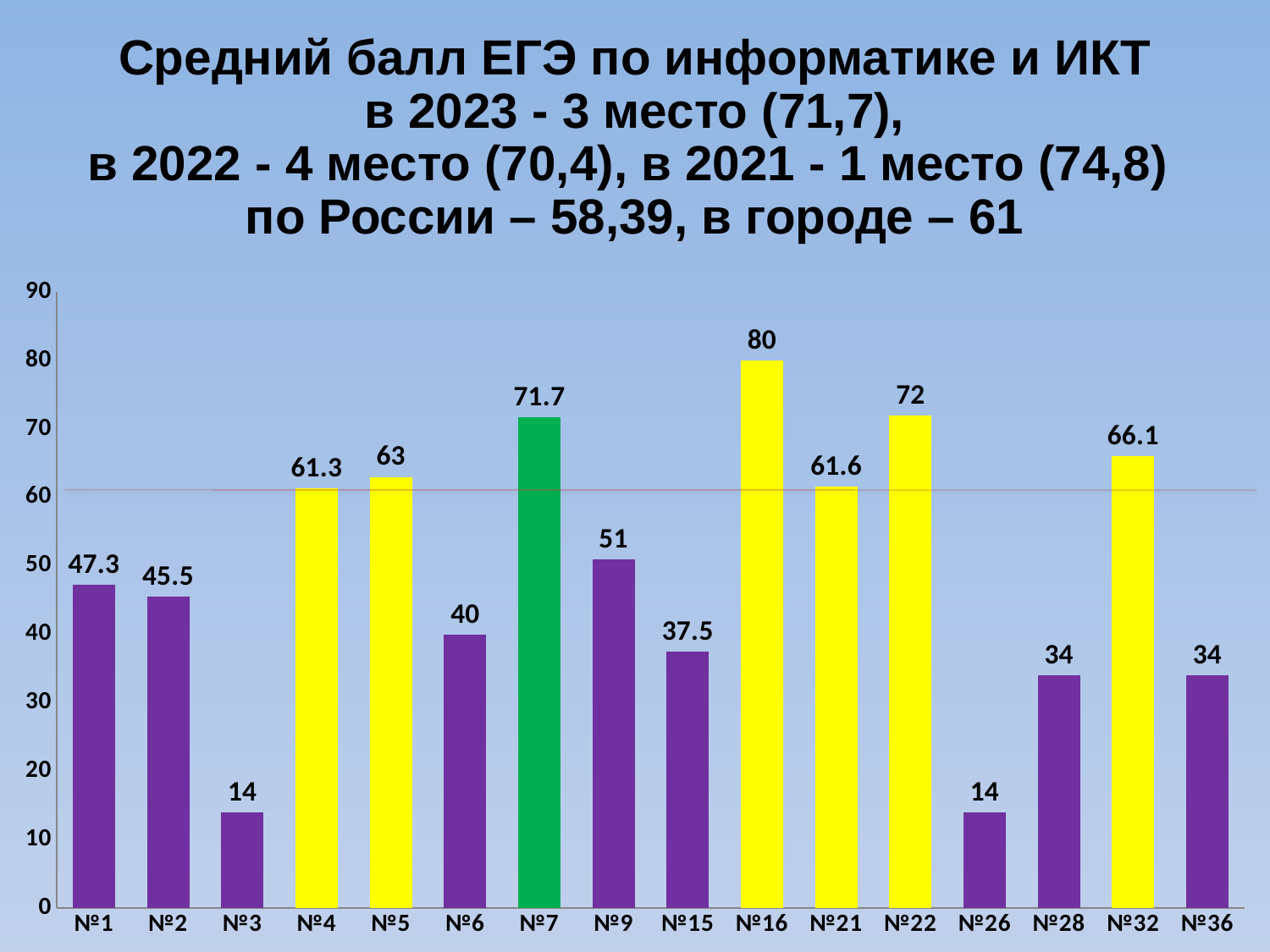
What kind of chart is shown on the slide? bar chart What is the value for №32? 66.1 What is the value for №16? 80 Is the value for №9 greater or less than 60? less Which category has the highest value? №16 What is the value for №15? 37.5 What is the value for №7? 71.7 How many categories are shown on the x axis? 16 What is the difference between the values for №16 and №22? 8 Which category has the lowest value, №3 or №28? №3 What is the difference between the values for №1 and №2? 1.8 Which is larger, the value for №5 or the value for №21? №5